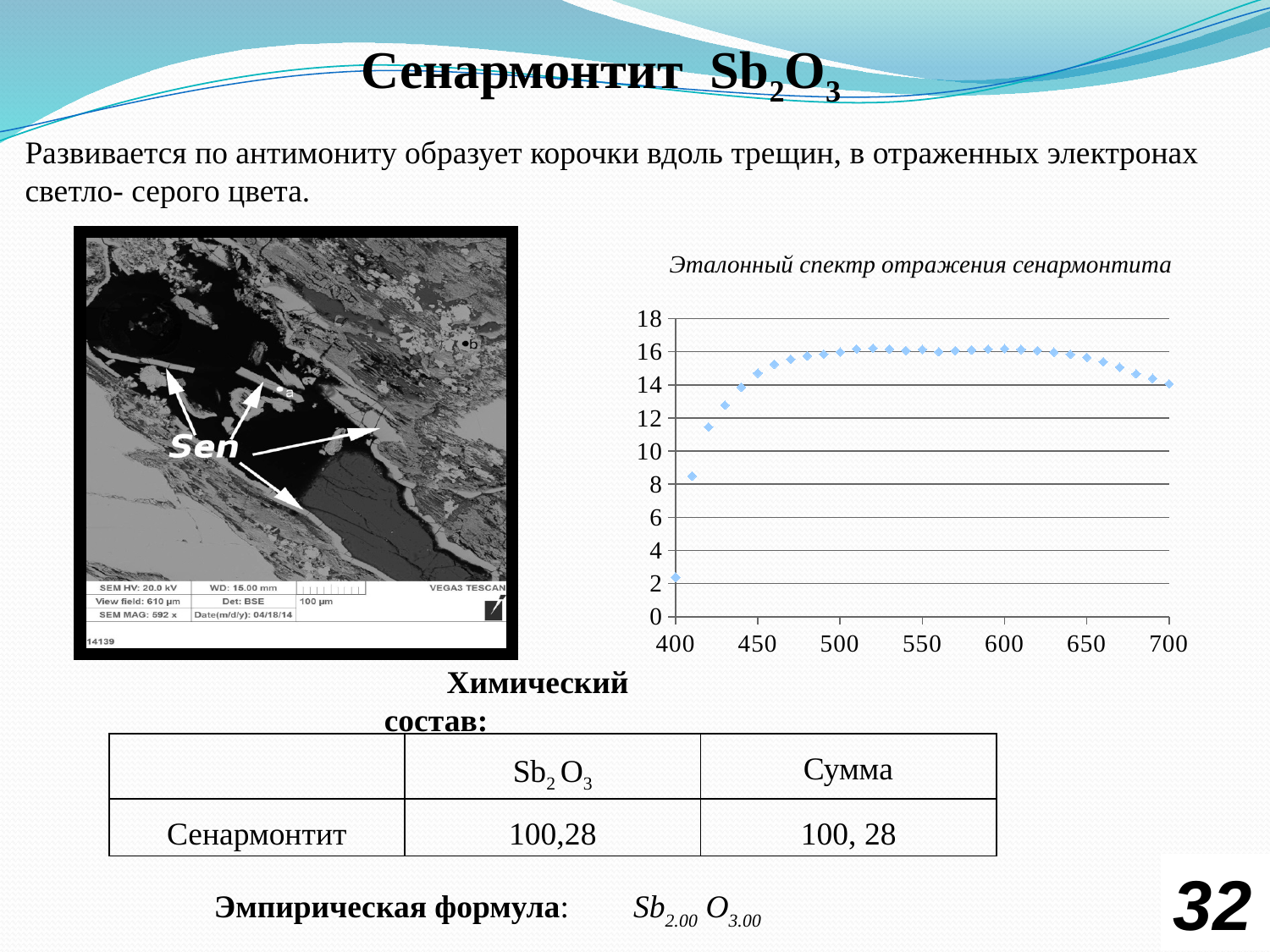
At which x value is the lowest point of the spectrum? 400 Is the value at x = 550 greater or less than 14? greater Is the value at x = 420 greater or less than 10? greater Which is larger, the value at x = 400 or the value at x = 700? 700 What is the highest value shown on the y axis of the chart? 18 Is the value at x = 450 greater or less than 12? greater What is the title of the chart on the slide? Эталонный спектр отражения сенармонтита Do the values rise or fall along the x axis between 400 and 500? rise What kind of chart is shown under the title 'Эталонный спектр отражения сенармонтита'? scatter chart Which is larger, the value at x = 410 or the value at x = 550? 550